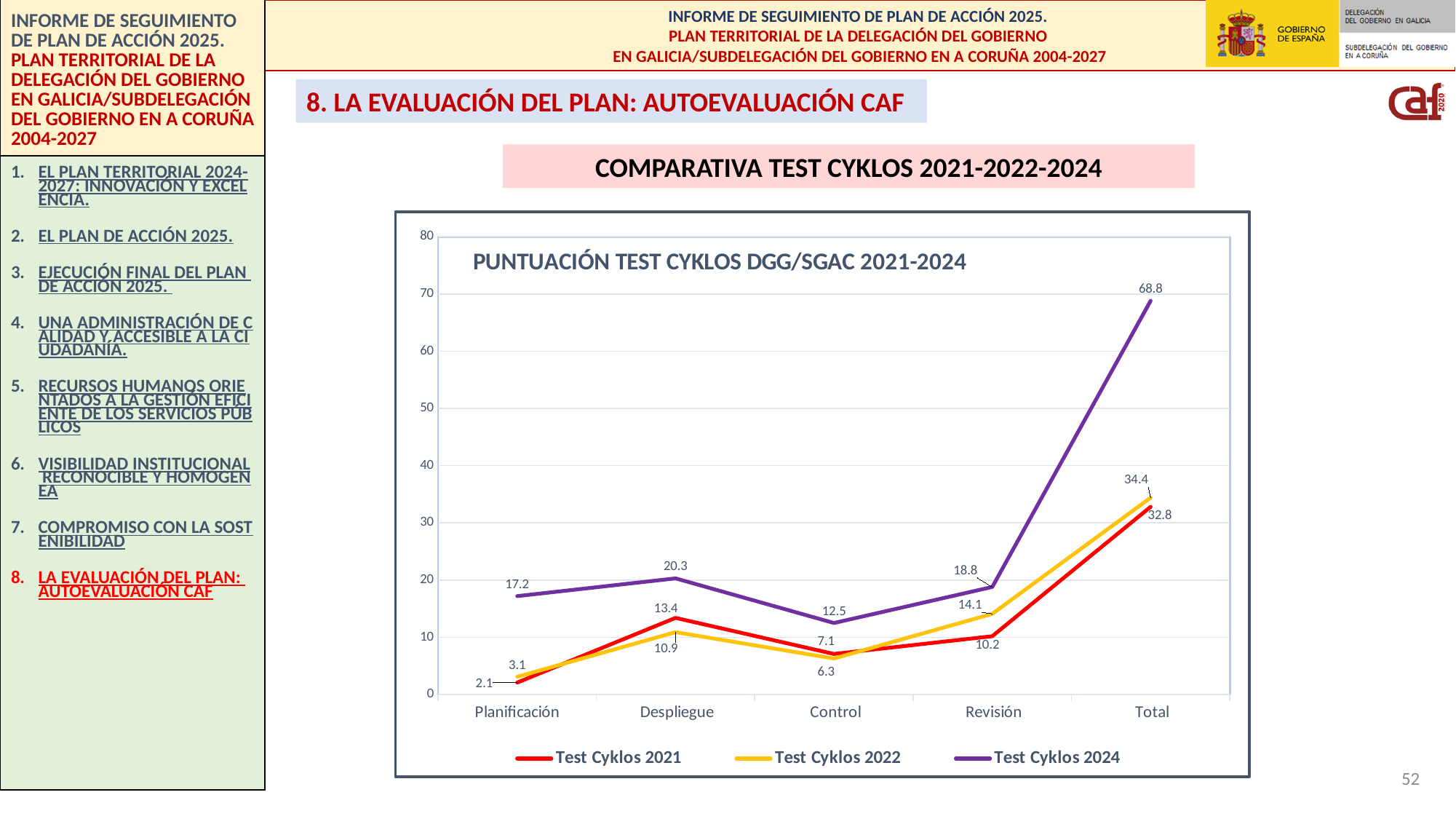
What is the value for Test Cyklos 2024 at Control? 12.5 How many categories are shown on the x axis? 5 Which category has the highest value for Test Cyklos 2024? Total What is the value for Test Cyklos 2024 at Total? 68.8 What is the title of the chart? PUNTUACIÓN TEST CYKLOS DGG/SGAC 2021-2024 What kind of chart is shown on the slide? line chart What is the difference between Test Cyklos 2024 and Test Cyklos 2022 at Total? 34.4 What is the value for Test Cyklos 2021 at Despliegue? 13.4 Which category has the lowest value for Test Cyklos 2021? Planificación Which is larger at Despliegue: Test Cyklos 2021 or Test Cyklos 2022? Test Cyklos 2021 How many series does the legend list? 3 What is the value for Test Cyklos 2022 at Revisión? 14.1